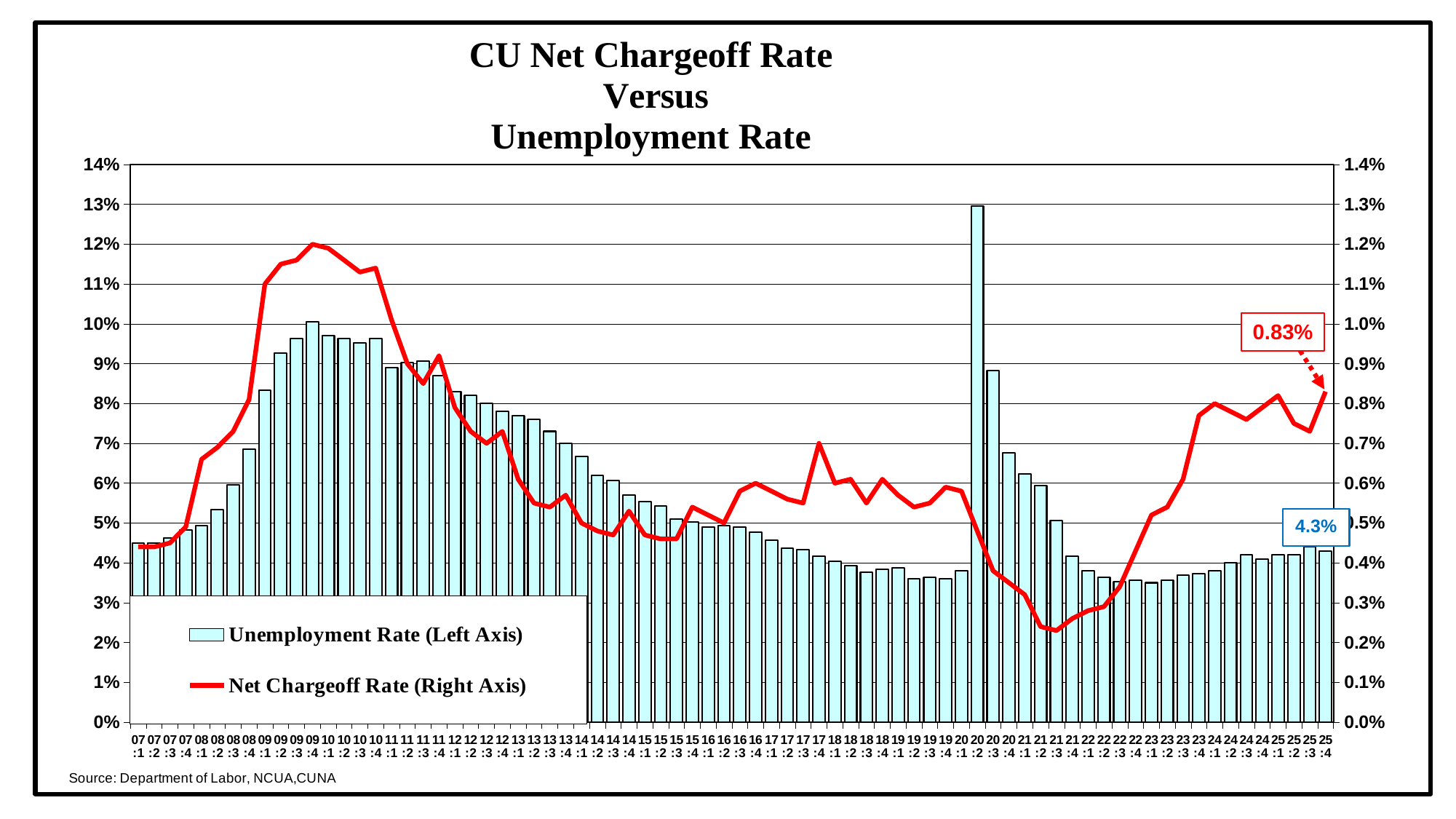
Is the Net Chargeoff Rate for 09:4 greater or less than 1.1%? greater Is the Unemployment Rate for 20:2 greater or less than 12%? greater Is the Unemployment Rate for 07:1 greater or less than 5%? less Which is larger, the Unemployment Rate for 09:4 or for 25:4? 09:4 What is the Net Chargeoff Rate labeled for 25:4? 0.83% What kind of chart is used to show the Unemployment Rate series? bar chart What is the title of the chart? CU Net Chargeoff Rate Versus Unemployment Rate Does the Unemployment Rate generally rise or fall from 10:1 to 19:4? fall In which quarter is the Unemployment Rate highest? 20:2 How many series does the legend list? 2 What is the Unemployment Rate labeled for 25:4? 4.3%